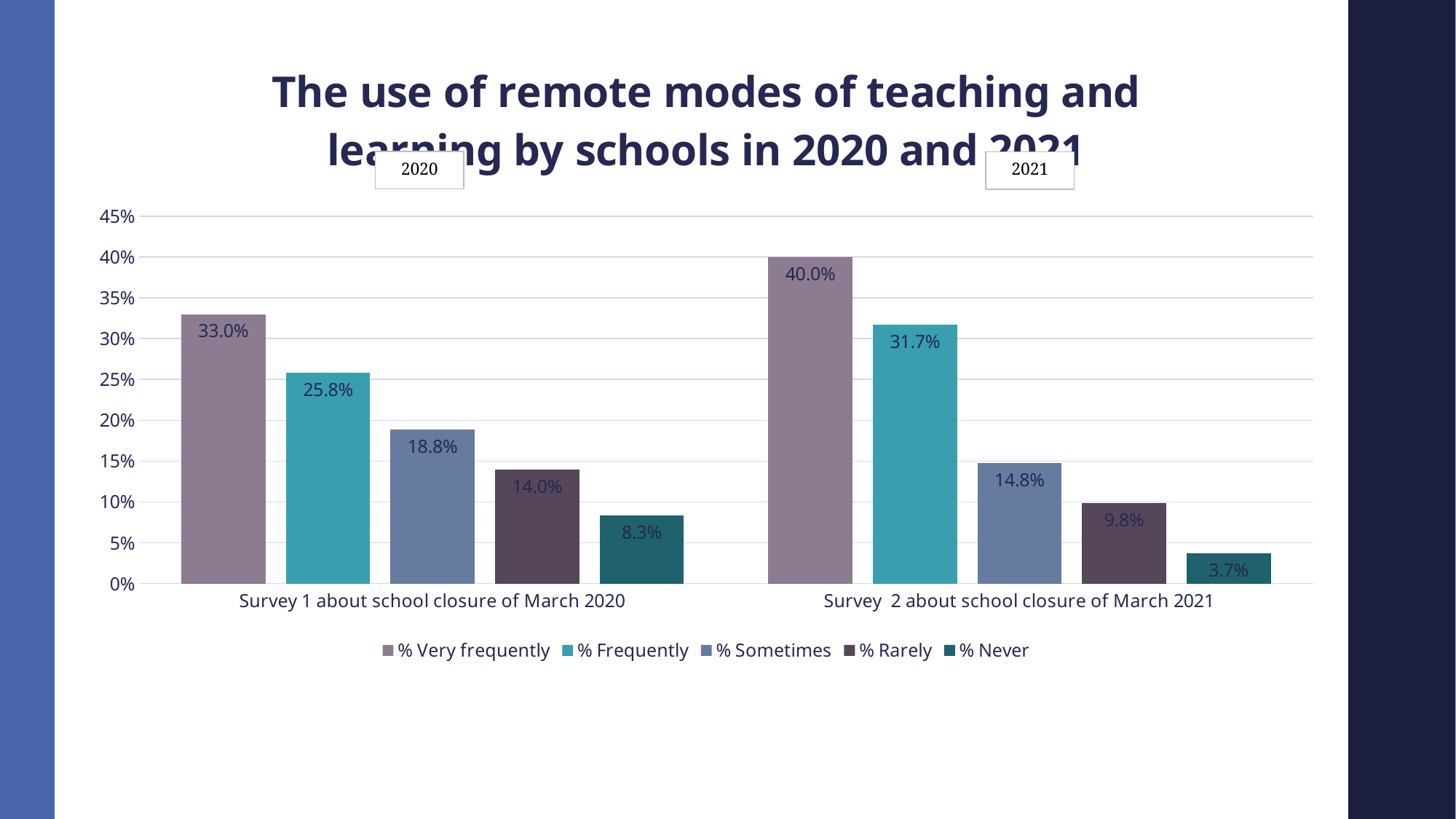
How many series does the legend list? 5 What kind of chart is shown on the slide? Bar chart Which is larger: % Frequently in Survey 1 (March 2020) or % Frequently in Survey 2 (March 2021)? Survey 2 (March 2021) Which series has the highest value in Survey 2 about school closure of March 2021? % Very frequently What is the title of the chart? The use of remote modes of teaching and learning by schools in 2020 and 2021 What is the value for % Sometimes in Survey 2 about school closure of March 2021? 14.8% Which series has the lowest value in Survey 1 about school closure of March 2020? % Never How many survey categories are shown on the x axis? 2 What is the value for % Very frequently in Survey 1 about school closure of March 2020? 33.0% What is the value for % Never in Survey 2 about school closure of March 2021? 3.7% What is the difference between % Rarely in Survey 1 (March 2020) and % Rarely in Survey 2 (March 2021)? 4.2% What is the difference between % Very frequently in Survey 2 (March 2021) and % Very frequently in Survey 1 (March 2020)? 7.0%